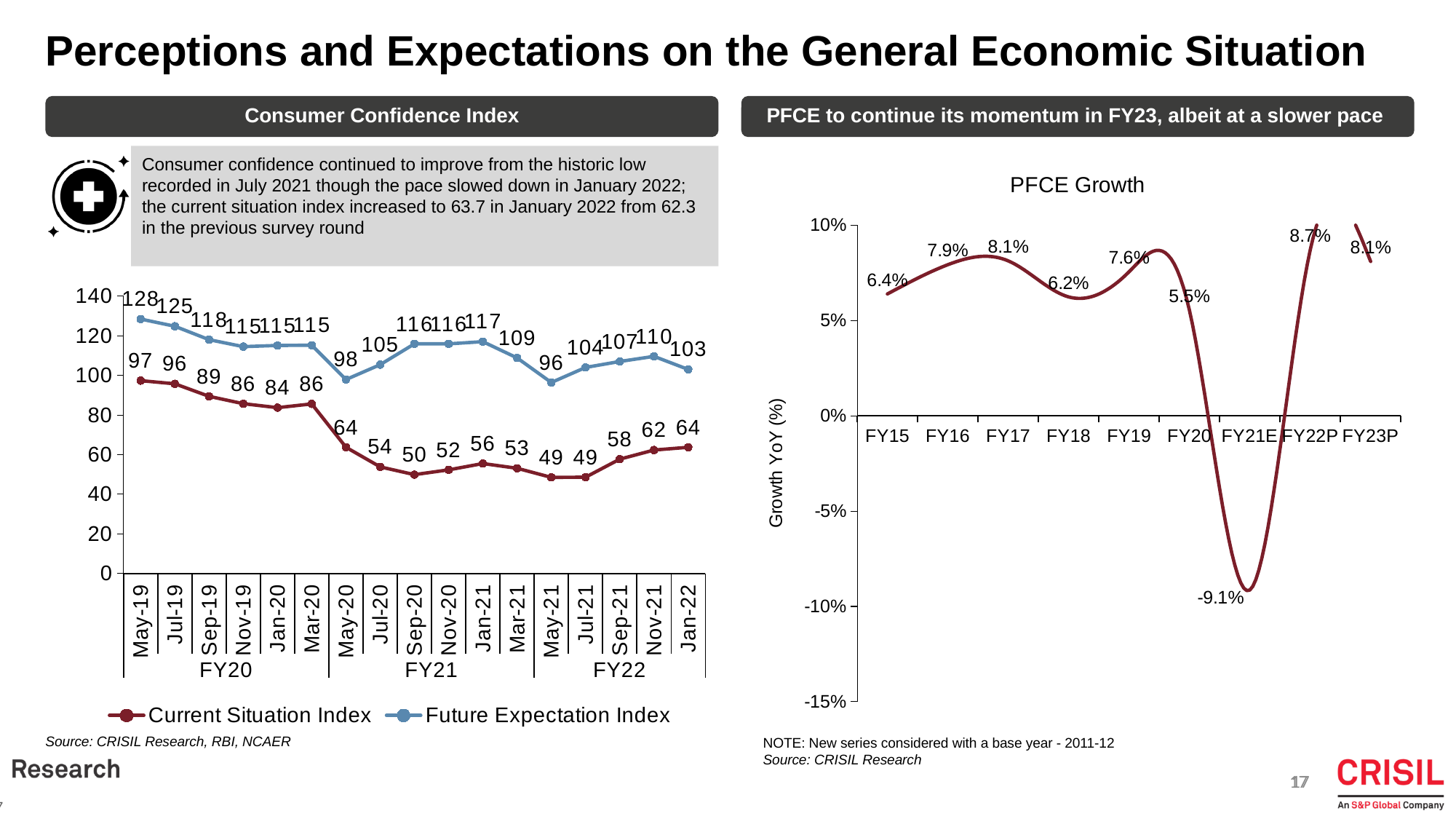
In the PFCE Growth chart, which fiscal year has the highest growth value? FY22P In the Consumer Confidence Index chart, what is the Current Situation Index value for Jan-22? 64 In the Consumer Confidence Index chart, how many series does the legend list? 2 In the PFCE Growth chart, what is the difference between the FY22P and FY23P growth values? 0.6% In the PFCE Growth chart, does the growth value rise or fall from FY17 to FY18? Fall In the Consumer Confidence Index chart, is the Current Situation Index higher in Mar-20 or in May-20? Mar-20 What type of chart is the PFCE Growth chart? Line chart In the Consumer Confidence Index chart, what is the Future Expectation Index value for May-19? 128 In the Consumer Confidence Index chart, what is the difference between the Future Expectation Index and the Current Situation Index in Sep-20? 66 In the Consumer Confidence Index chart, which month has the lowest Future Expectation Index value? May-21 In the PFCE Growth chart, what is the growth value for FY21E? -9.1% In the Consumer Confidence Index chart, how many months are plotted on the x axis? 17